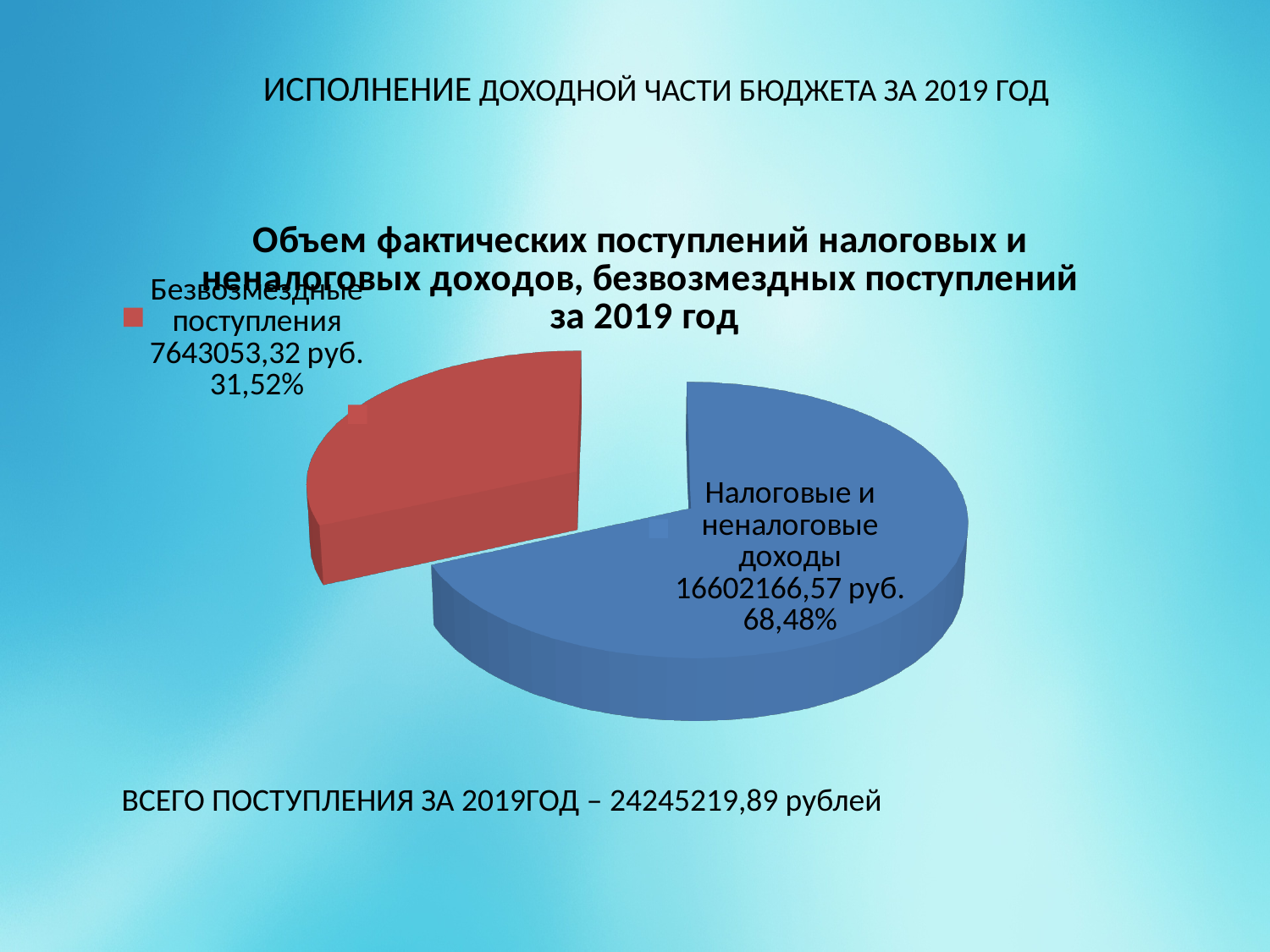
Which is larger: Налоговые и неналоговые доходы or Безвозмездные поступления? Налоговые и неналоговые доходы What year does the pie chart's title refer to? 2019 What colour is the slice for Безвозмездные поступления? Red Which slice of the pie chart is the smallest? Безвозмездные поступления How many slices does the pie chart have? 2 What is the value shown for Безвозмездные поступления? 7643053,32 руб. What share of the pie does Безвозмездные поступления represent? 31,52% What is the difference in percentage points between the share of Налоговые и неналоговые доходы and the share of Безвозмездные поступления? 36,96% What kind of chart is shown on the slide? Pie chart What is the value shown for Налоговые и неналоговые доходы? 16602166,57 руб. What share of the pie does Налоговые и неналоговые доходы represent? 68,48% Which slice of the pie chart is the largest? Налоговые и неналоговые доходы